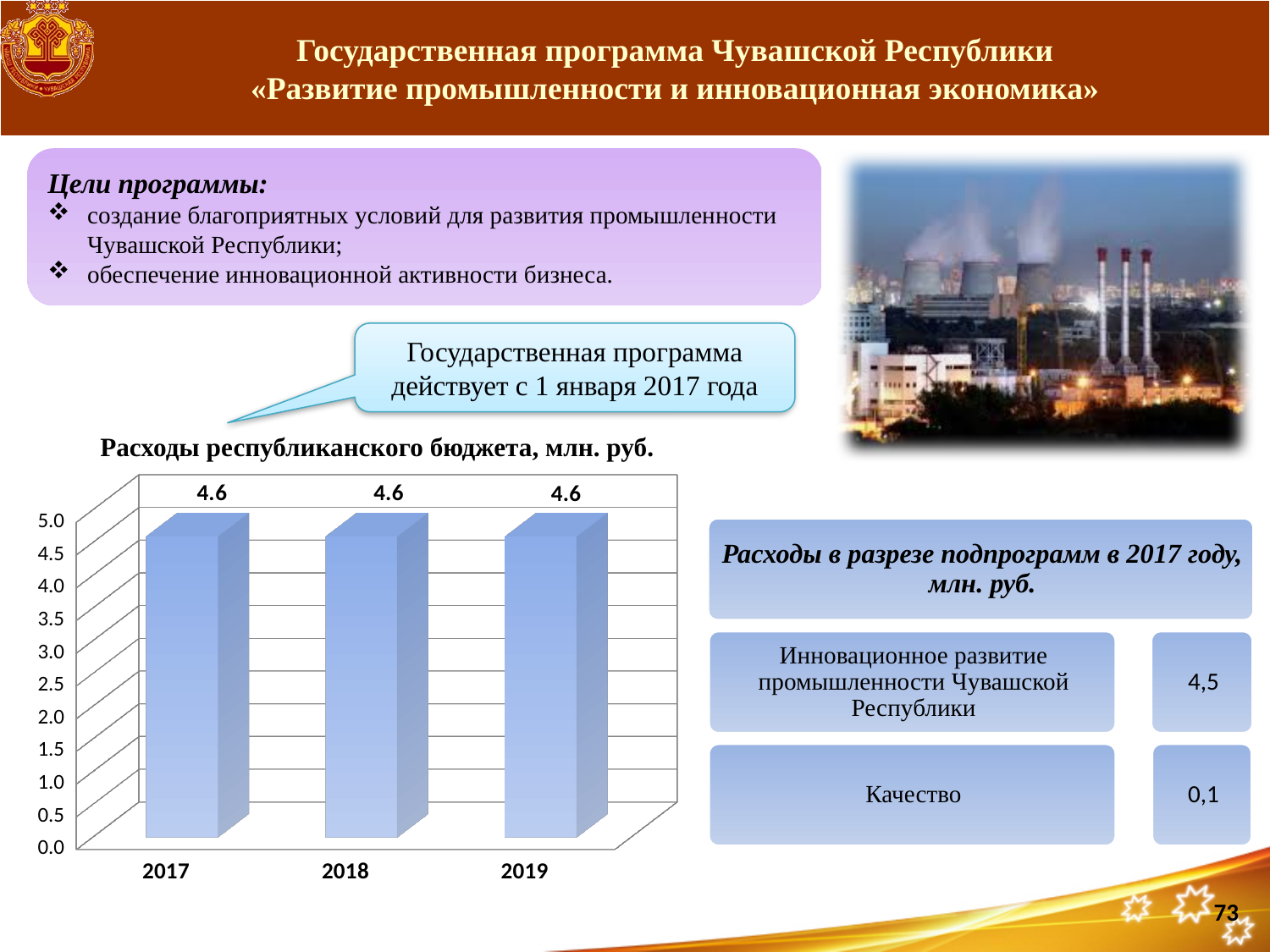
What kind of chart is shown on the slide? bar chart How many years are shown on the x axis of the chart? 3 What is the value for 2017 in the chart? 4.6 Is the value for 2018 greater or less than 4.0? greater What is the title of the chart? Расходы республиканского бюджета, млн. руб. What is the value for 2019 in the chart? 4.6 What is the highest tick value shown on the vertical axis of the chart? 5.0 Is the value for 2017 greater or less than 5.0? less Do the values rise, fall or stay the same from 2017 to 2019? stay the same What is the value for 2018 in the chart? 4.6 What is the difference between the values for 2019 and 2017? 0